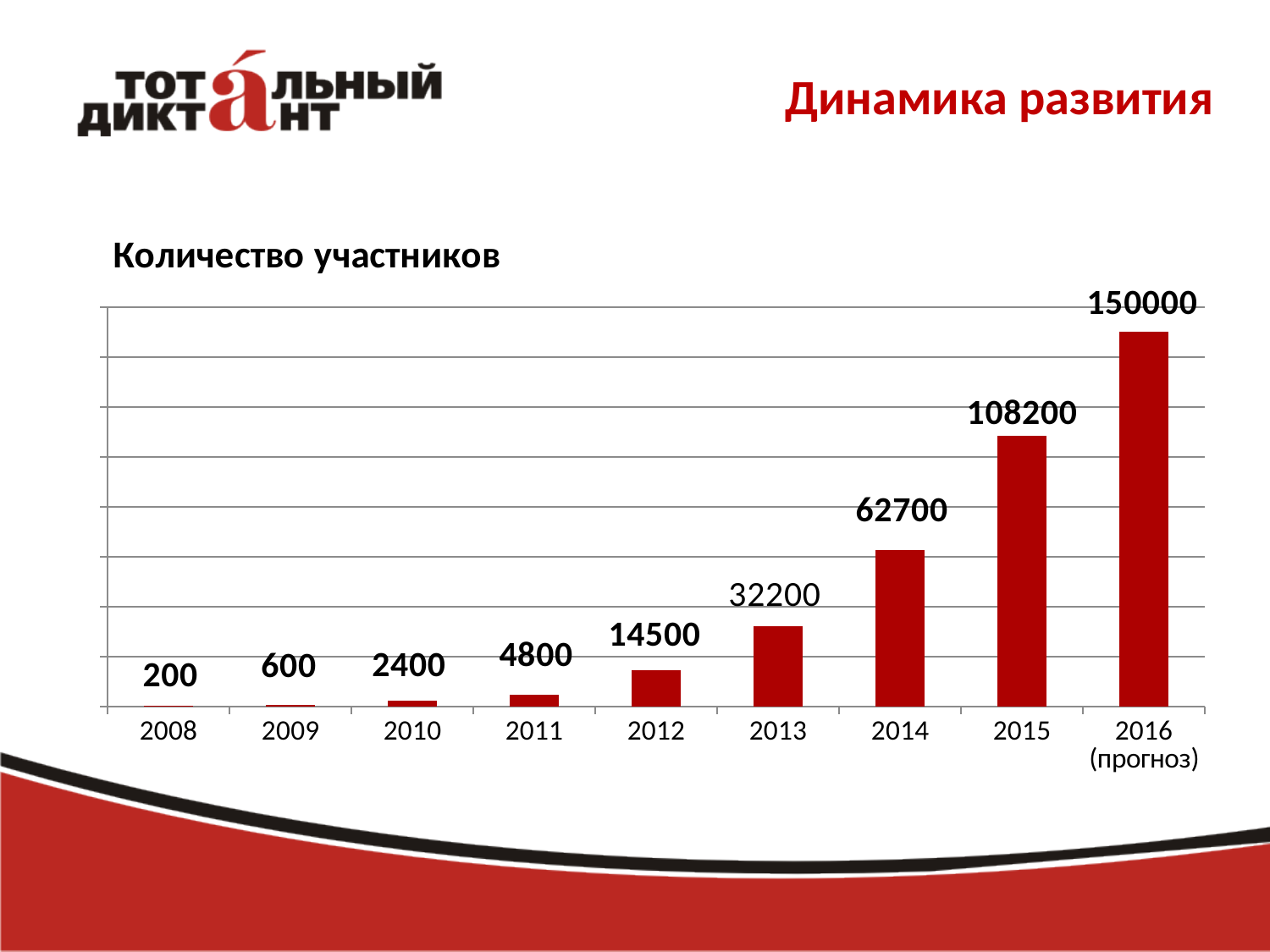
Which year has the lowest number of participants? 2008 What is the forecast value shown for 2016 (прогноз)? 150000 What kind of chart is shown on the slide? bar chart What value is shown for 2010? 2400 How many years (categories) are shown on the x axis? 9 Which year has the highest number of participants? 2016 (прогноз) Which is larger, the value for 2013 or the value for 2014? 2014 What is the number of participants shown for 2013? 32200 Do the values rise or fall from 2008 to 2016? rise What is the difference between the values for 2015 and 2014? 45500 What is the title of the chart? Количество участников What is the difference between the values for 2012 and 2011? 9700